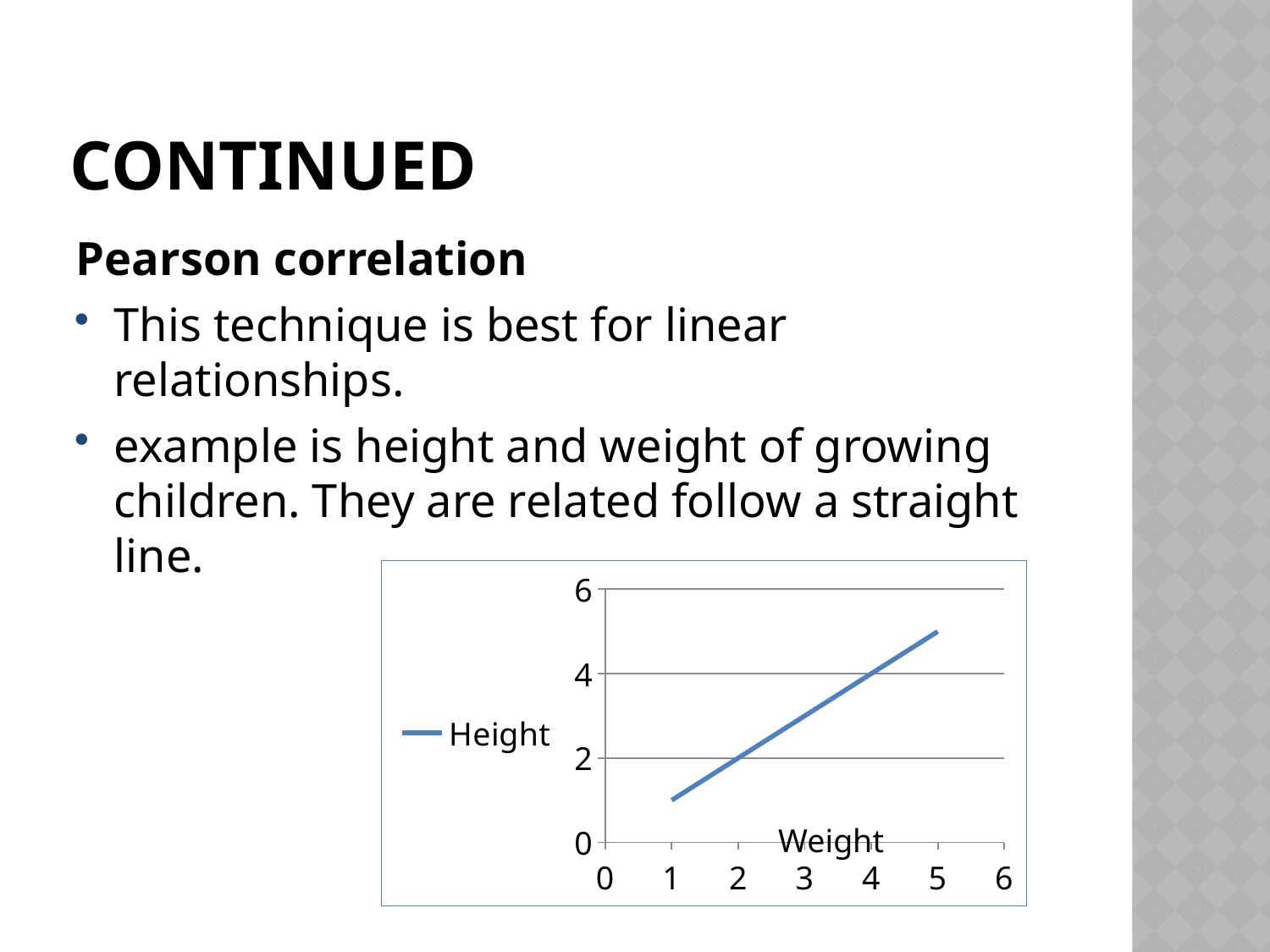
What kind of chart is shown on the slide? line chart What is the label on the chart's horizontal axis? Weight What is the Height value where the line crosses Weight 4? 4 Is the Height value at Weight 1 greater or less than 2? less What is the Height value where the line crosses Weight 2? 2 How many series does the chart's legend list? 1 Is the Height value at Weight 5 greater or less than 4? greater At which Weight value does the Height line reach its lowest point? 1 At which Weight value does the Height line reach its highest point? 5 What is the name of the series shown in the chart's legend? Height Does the Height line rise or fall as Weight increases along the x axis? rises Which is larger, the Height value at Weight 5 or the Height value at Weight 1? Weight 5